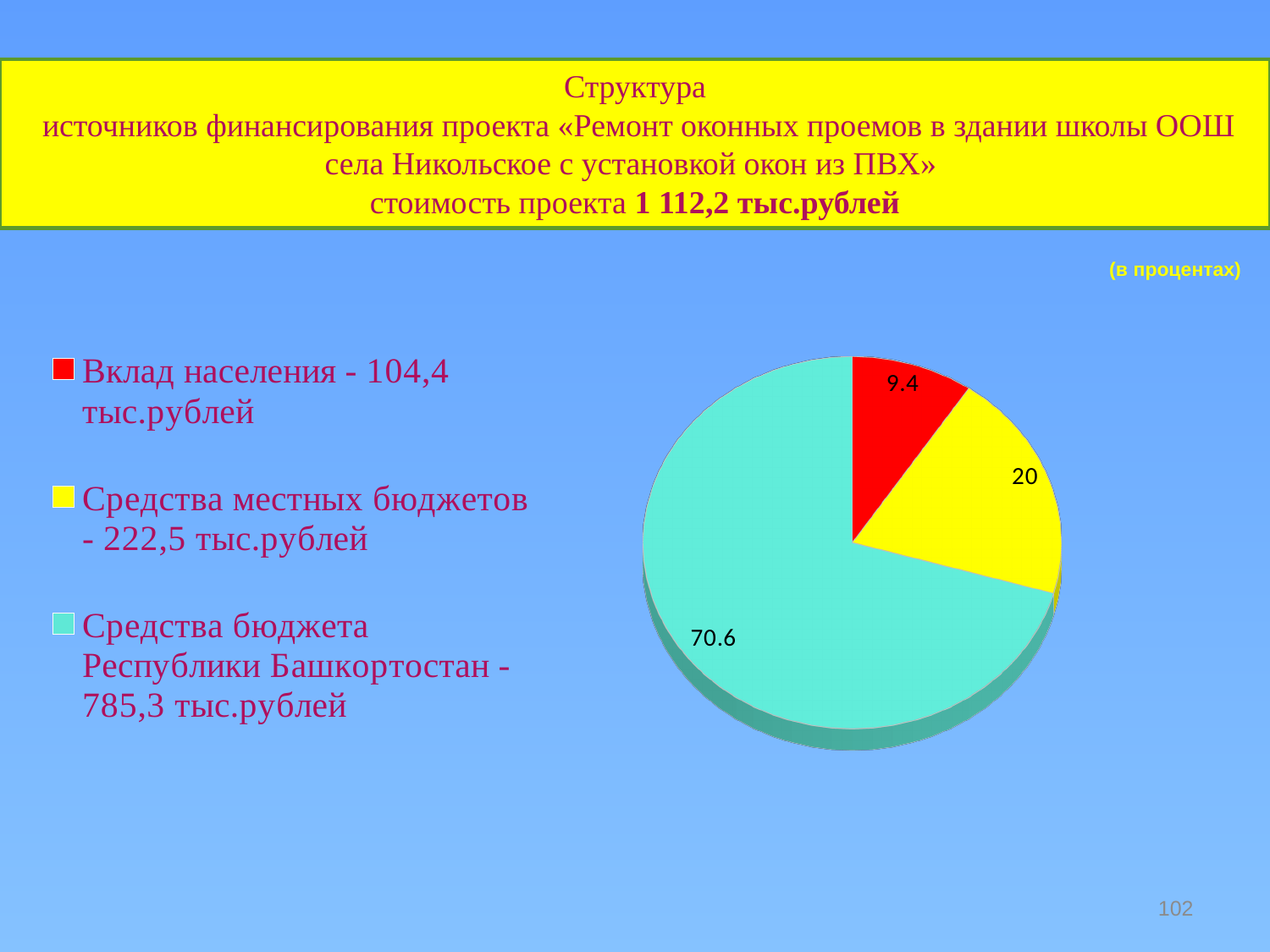
Which funding source has the largest share of the pie? Средства бюджета Республики Башкортостан What kind of chart is shown on the slide? pie chart Which funding source has the smallest share of the pie? Вклад населения What colour is the slice representing "Средства бюджета Республики Башкортостан"? light blue (cyan) What percentage is shown for the slice "Средства местных бюджетов"? 20 How many slices does the pie chart have? 3 What is the difference in percentage points between the "Средства местных бюджетов" slice and the "Вклад населения" slice? 10.6 What percentage is shown for the slice "Вклад населения"? 9.4 According to the legend, what amount in тыс.рублей corresponds to "Средства местных бюджетов"? 222,5 тыс.рублей What percentage is shown for the slice "Средства бюджета Республики Башкортостан"? 70.6 How many entries does the legend list? 3 Which is larger: the share for "Средства местных бюджетов" or the share for "Вклад населения"? Средства местных бюджетов